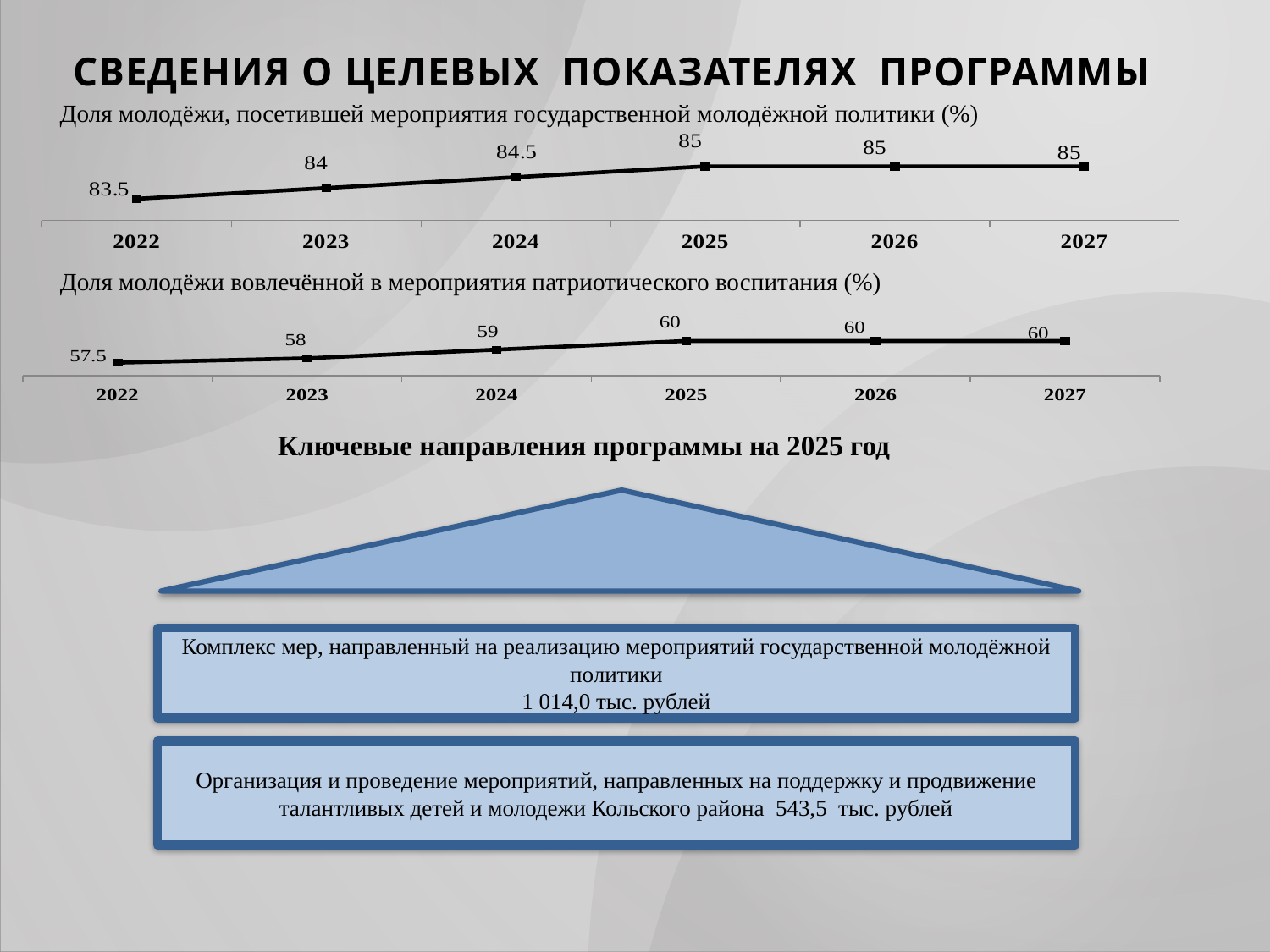
In the bottom chart, what is the difference between the values for 2024 and 2023? 1 In the top chart, what is the difference between the values for 2025 and 2022? 1.5 In the top chart (share of youth attending state youth policy events), what is the value for 2024? 84.5 In the top chart, do the values rise or fall from 2022 to 2025? rise In the bottom chart (share of youth involved in patriotic education events), what is the value for 2024? 59 In the bottom chart, which year has the lowest value? 2022 How many years are plotted on the x axis of the top chart? 6 What type of chart is the bottom chart? line chart In the top chart, which year has the lowest value? 2022 In the bottom chart (share of youth involved in patriotic education events), what is the value for 2022? 57.5 In the bottom chart, which is larger: the value for 2023 or the value for 2025? 2025 In the top chart (share of youth attending state youth policy events), what is the value for 2022? 83.5